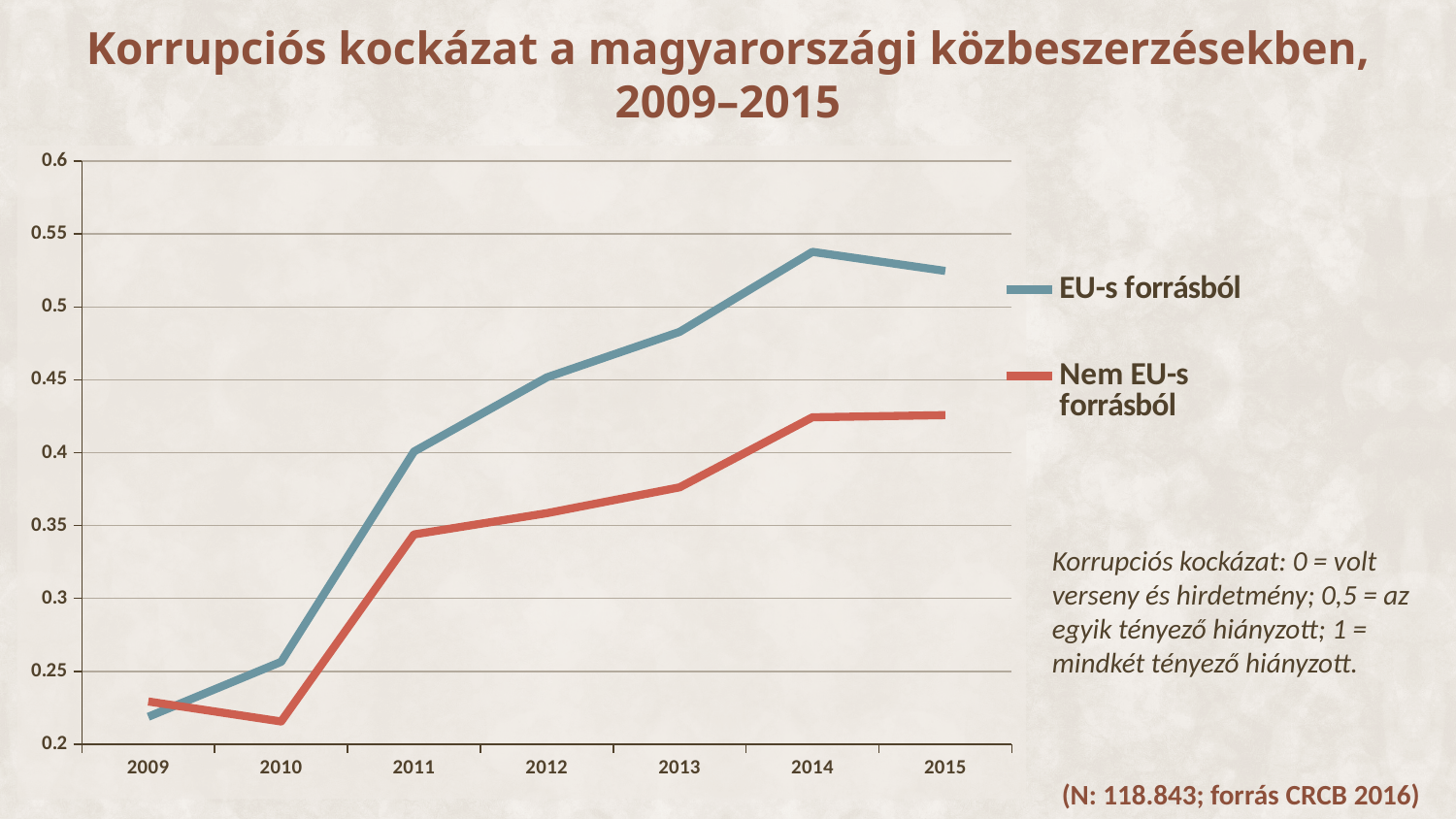
Is the value for 'Nem EU-s forrásból' in 2010 greater or less than 0.25? less Is the value for 'Nem EU-s forrásból' in 2014 greater or less than 0.45? less In which year is the 'EU-s forrásból' series at its lowest value? 2009 Is the value for 'EU-s forrásból' in 2014 greater or less than 0.5? greater What kind of chart is shown on the slide? line chart In 2013, which series has the higher value, 'EU-s forrásból' or 'Nem EU-s forrásból'? EU-s forrásból Does the 'EU-s forrásból' series rise or fall between 2010 and 2014? rise How many years are plotted along the x axis? 7 In which year does the 'EU-s forrásból' series reach its highest value? 2014 How many series does the legend list? 2 In which year is the 'Nem EU-s forrásból' series at its lowest value? 2010 Which colour is used for the 'Nem EU-s forrásból' series? red